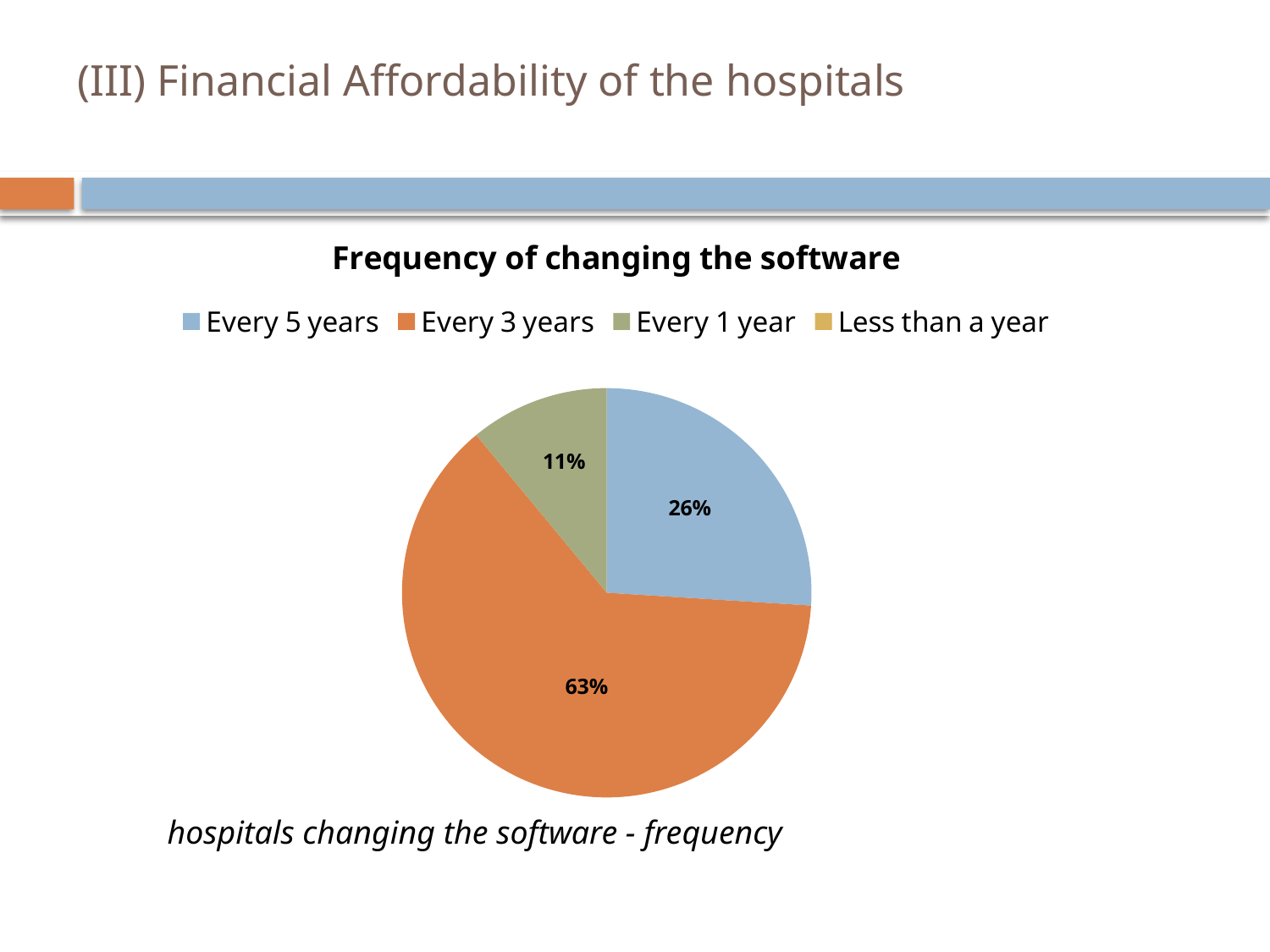
What is the title of the chart? Frequency of changing the software What kind of chart is shown on the slide? pie chart How many slices have a percentage label printed on the pie? 3 What colour is the 'Every 3 years' slice? orange Which is larger, the share for 'Every 5 years' or the share for 'Every 1 year'? Every 5 years What percentage of hospitals change the software every 5 years? 26% What is the difference in percentage points between the 'Every 3 years' and 'Every 5 years' slices? 37 Which category has the largest share of the pie? Every 3 years How many entries does the legend list? 4 What percentage of hospitals change the software every 3 years? 63% What percentage of hospitals change the software every 1 year? 11% Which labelled slice has the smallest share of the pie? Every 1 year